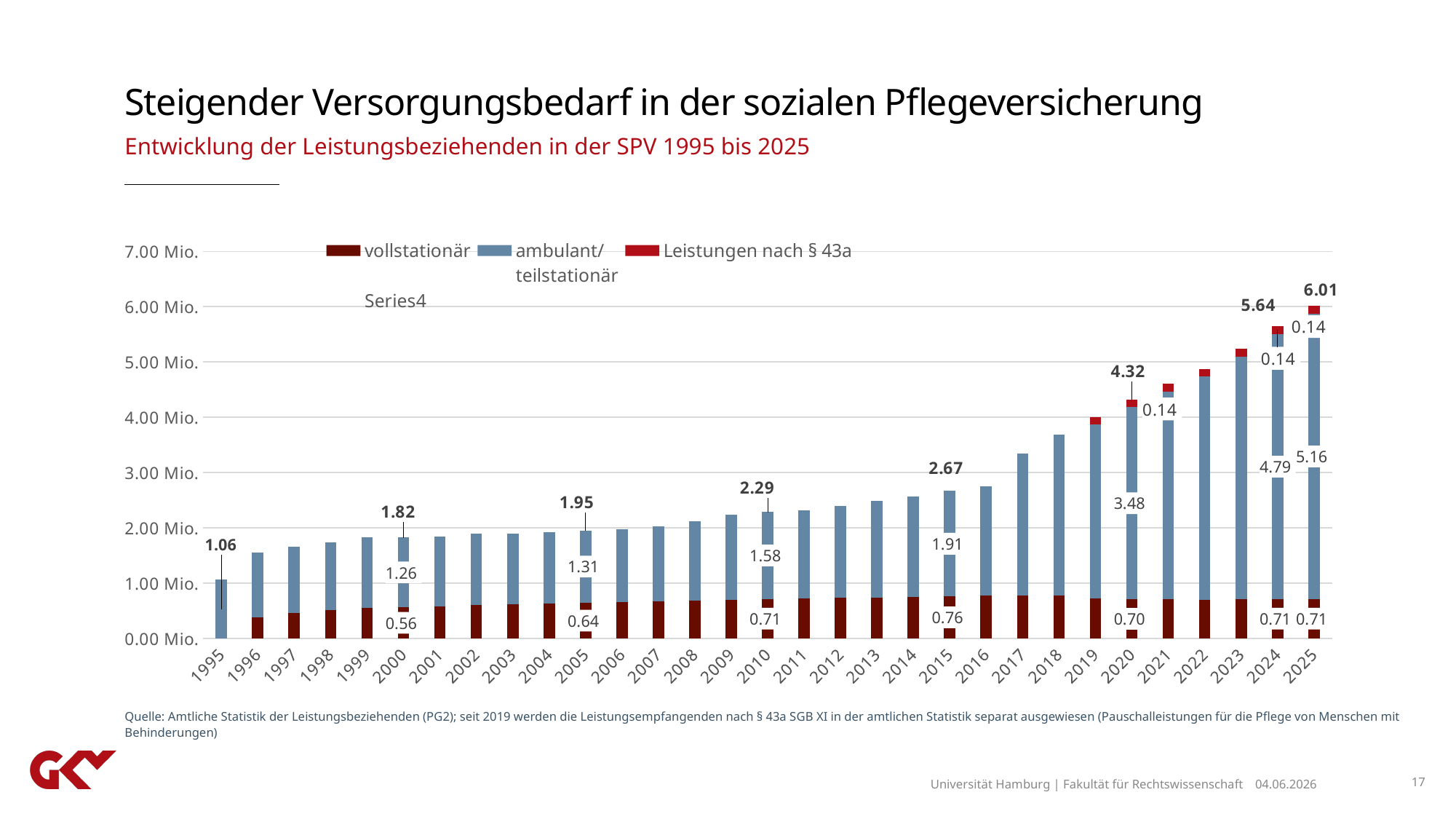
Is the total bar for 2018 greater or less than 3.00 Mio.? greater What is the difference between the total for 2025 and the total for 2024? 0.37 What type of chart is shown on the slide? stacked bar chart Do the total bar heights generally rise or fall from 1995 to 2025? rise What is the total number of Leistungsbeziehende shown for 2025? 6.01 What is the value of the Leistungen nach § 43a segment for 2024? 0.14 What is the value of the vollstationär segment for 2005? 0.64 How many years are shown on the x axis? 31 What is the value of the ambulant/teilstationär segment for 2020? 3.48 Which year has the highest total bar? 2025 Which year has the lowest total bar? 1995 Which is larger, the ambulant/teilstationär value for 2015 or for 2010? 2015